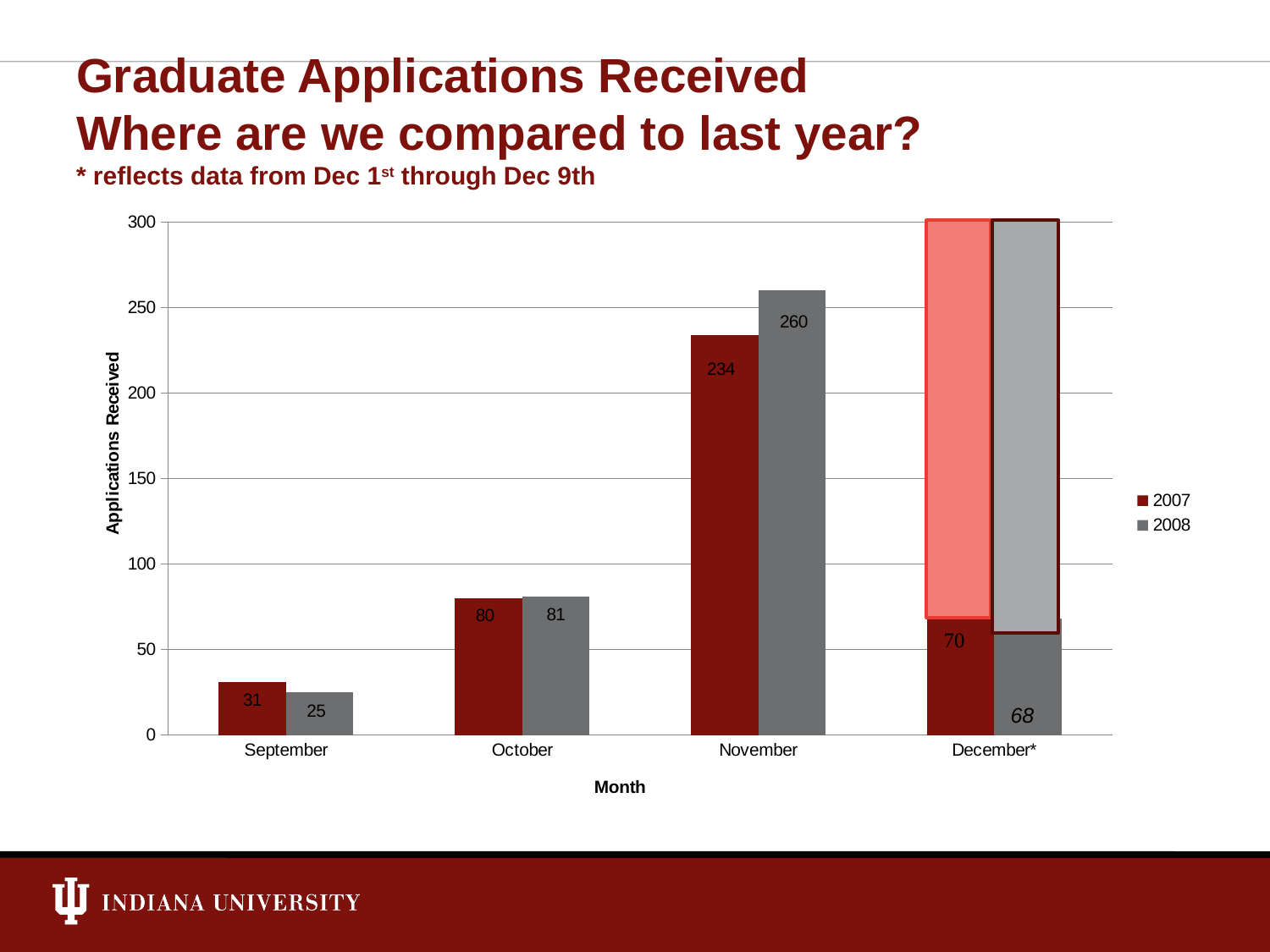
In December*, which series has the larger value, 2007 or 2008? 2007 How many months are shown on the x axis? 4 Which month has the highest value for the 2007 series? November What is the difference between the 2007 and 2008 values in September? 6 How many applications were received in November 2008? 260 Is the value for November 2008 greater or less than 250? greater How many series does the legend list? 2 What is the difference between the 2008 and 2007 values in November? 26 What kind of chart is shown on the slide? bar chart What is the value for 2008 in December*? 68 What is the value for 2007 in September? 31 Which month has the lowest value for the 2008 series? September